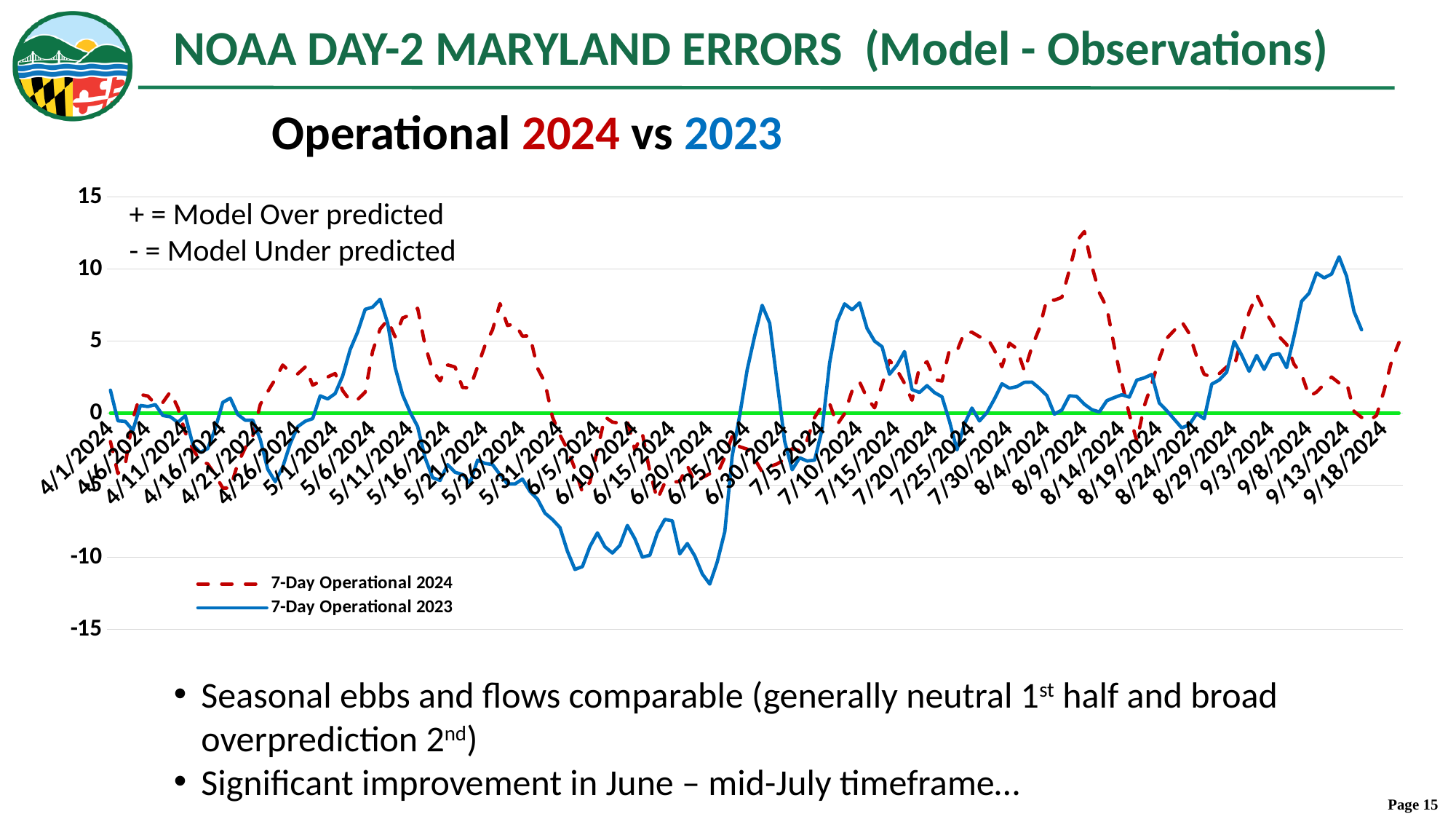
Which series is drawn as a red dashed line? 7-Day Operational 2024 Which series reaches the lowest value on the chart? 7-Day Operational 2023 Is the 7-Day Operational 2023 value around 5/11/2024 greater or less than 5? less Between 8/9/2024 and 8/14/2024, does the 7-Day Operational 2024 line rise or fall? fall Between 9/13/2024 and 9/18/2024, does the 7-Day Operational 2023 line rise or fall? fall Is the 7-Day Operational 2024 value around 8/9/2024 greater or less than 10? greater What type of chart is shown on the slide? line chart Is the 7-Day Operational 2024 value around 9/3/2024 greater or less than 5? greater What are the two series named in the legend? 7-Day Operational 2024 and 7-Day Operational 2023 How many series does the chart legend list? 2